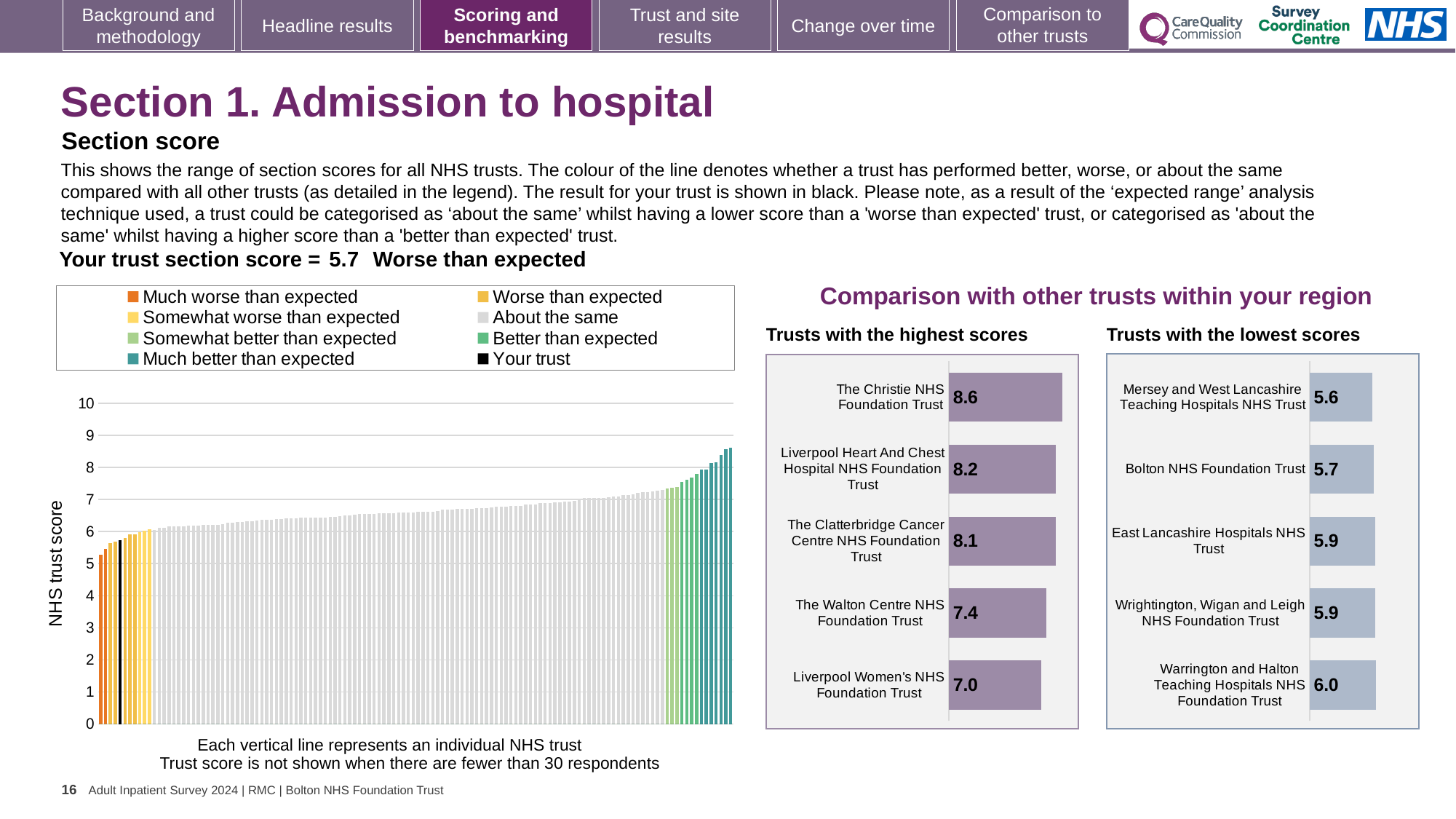
In the 'Trusts with the highest scores' chart, what is the score for The Christie NHS Foundation Trust? 8.6 In the 'Trusts with the lowest scores' chart, what is the score for Mersey and West Lancashire Teaching Hospitals NHS Trust? 5.6 What kind of chart is the 'NHS trust score' chart on the left of the slide? Bar chart In the 'Trusts with the lowest scores' chart, which trust has the highest score? Warrington and Halton Teaching Hospitals NHS Foundation Trust In the 'NHS trust score' chart on the left, do the values rise or fall from left to right along the x axis? Rise In the 'Trusts with the highest scores' chart, what is the difference between the scores of The Christie NHS Foundation Trust and Liverpool Women's NHS Foundation Trust? 1.6 In the 'Trusts with the highest scores' chart, what is the score for The Walton Centre NHS Foundation Trust? 7.4 How many trusts are shown in the 'Trusts with the highest scores' chart? 5 In the 'Trusts with the lowest scores' chart, what is the difference between the scores of Warrington and Halton Teaching Hospitals NHS Foundation Trust and Bolton NHS Foundation Trust? 0.3 In the 'Trusts with the lowest scores' chart, which has the larger score: Bolton NHS Foundation Trust or East Lancashire Hospitals NHS Trust? East Lancashire Hospitals NHS Trust How many entries does the legend of the 'NHS trust score' chart on the left list? 8 In the 'Trusts with the highest scores' chart, which trust has the lowest score? Liverpool Women's NHS Foundation Trust